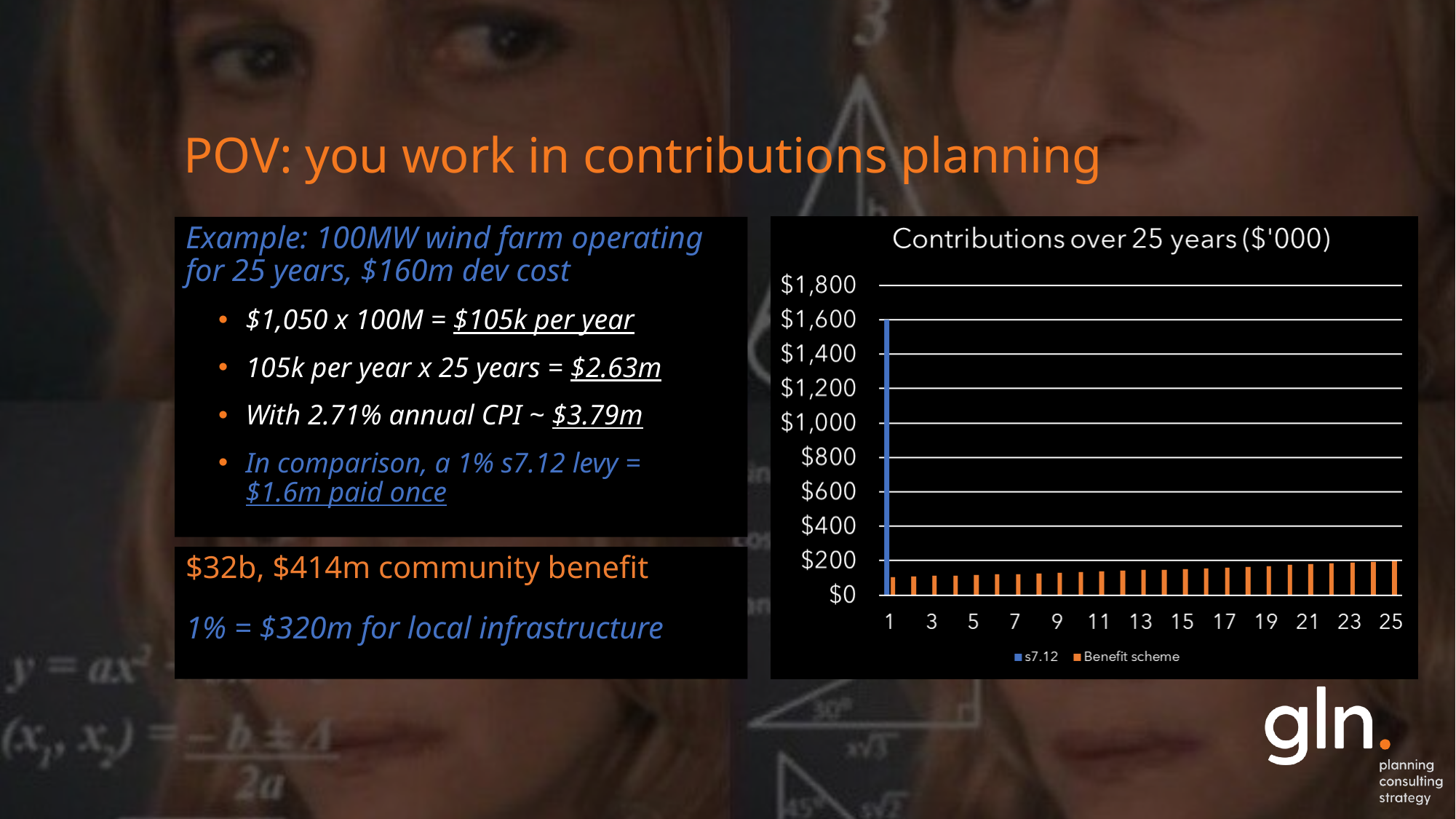
In year 1, which series has the larger value, s7.12 or Benefit scheme? s7.12 What are the two series named in the chart legend? s7.12 and Benefit scheme How many years are shown along the x axis of the chart? 25 Is the Benefit scheme value in year 25 greater or less than $400? less What kind of chart is shown on the slide? bar chart In which year does the s7.12 series have its highest value? 1 What is the title of the chart? Contributions over 25 years ($'000) Is the s7.12 value in year 1 greater or less than $1,000? greater What is the value of the s7.12 series in year 1? $1,600 Do the Benefit scheme values rise or fall from year 1 to year 25? rise How many series does the chart legend list? 2 Is the Benefit scheme value in year 1 greater or less than $200? less